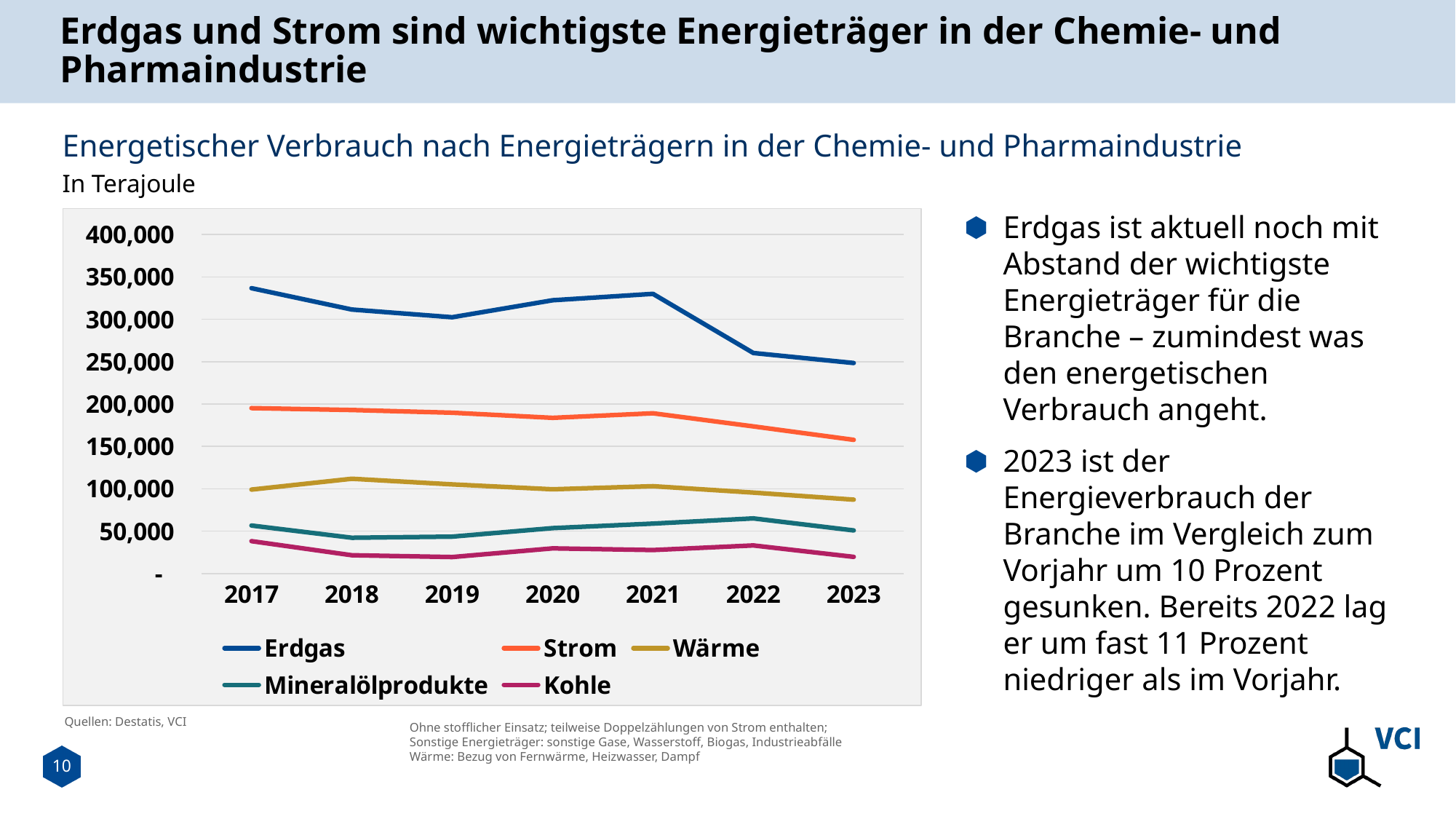
Is the value for Erdgas in 2023 greater or less than 300,000? less Is the value for Kohle in 2019 greater or less than 50,000? less Is the value for Erdgas in 2017 greater or less than 300,000? greater In what unit are the values on the chart given? Terajoule Which energy source has the lowest consumption in 2023? Kohle Which is larger in 2020, Wärme or Mineralölprodukte? Wärme How many series does the legend list? 5 Does the Erdgas line rise or fall from 2021 to 2023? fall What kind of chart is shown on the slide? line chart Which energy source has the highest consumption in 2023? Erdgas How many years are plotted along the x axis? 7